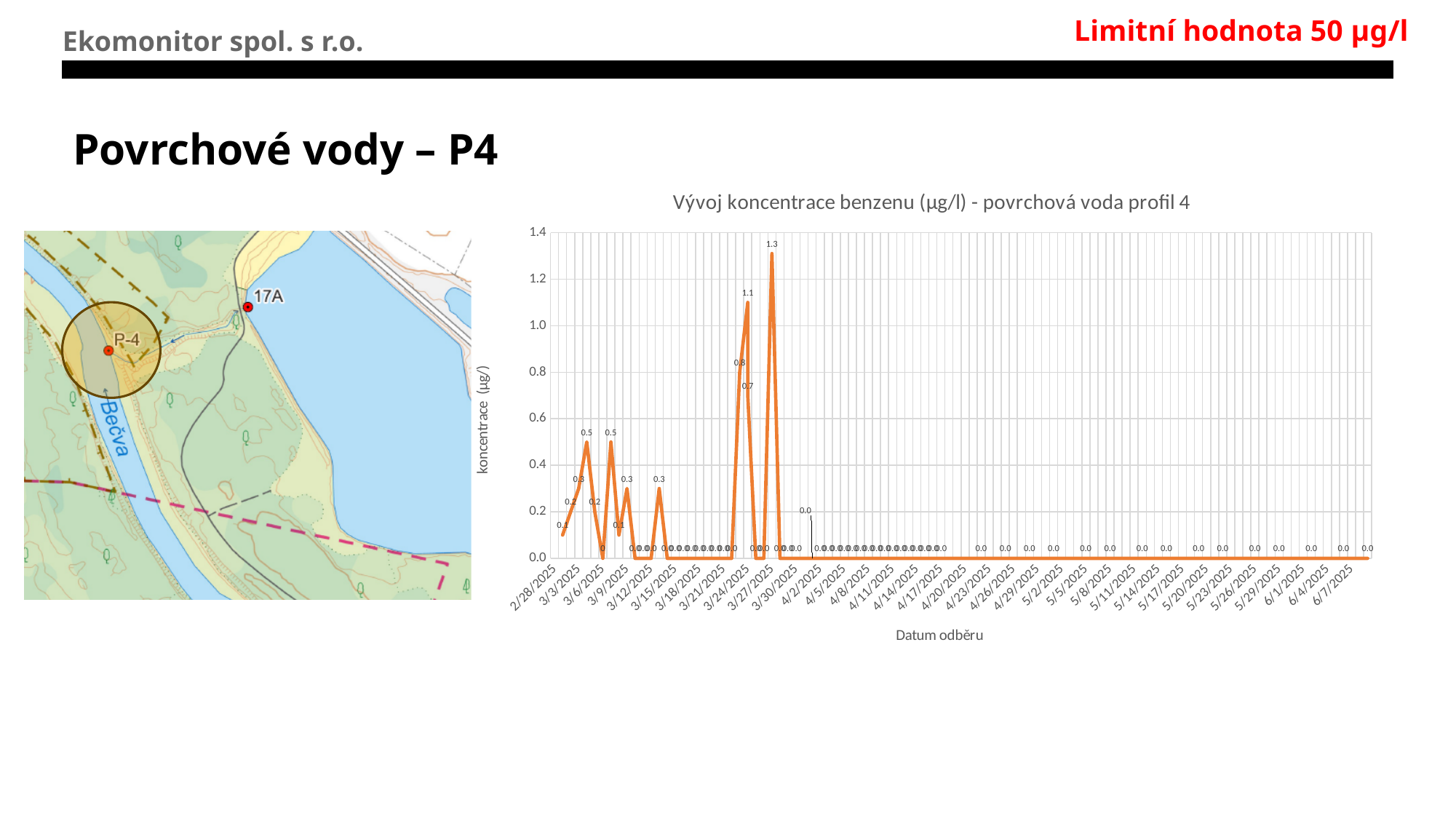
What is the title of the chart? Vývoj koncentrace benzenu (µg/l) - povrchová voda profil 4 Which is larger: the peak labelled 1.1 or the peak labelled 1.3? 1.3 What is the difference between the two highest labelled peaks, 1.3 and 1.1? 0.2 What is the concentration value labelled at the first point, 2/28/2025? 0.1 Is the highest value on the chart greater or less than 1.0? greater What is the highest benzene concentration value labelled on the chart? 1.3 What kind of chart is shown on the slide? line chart Is the highest value on the chart greater or less than 1.4? less What is the label of the x axis of the chart? Datum odběru Do the concentration values generally rise or fall from late March 2025 to June 2025? fall What value do the points from mid-April 2025 to June 2025 show? 0.0